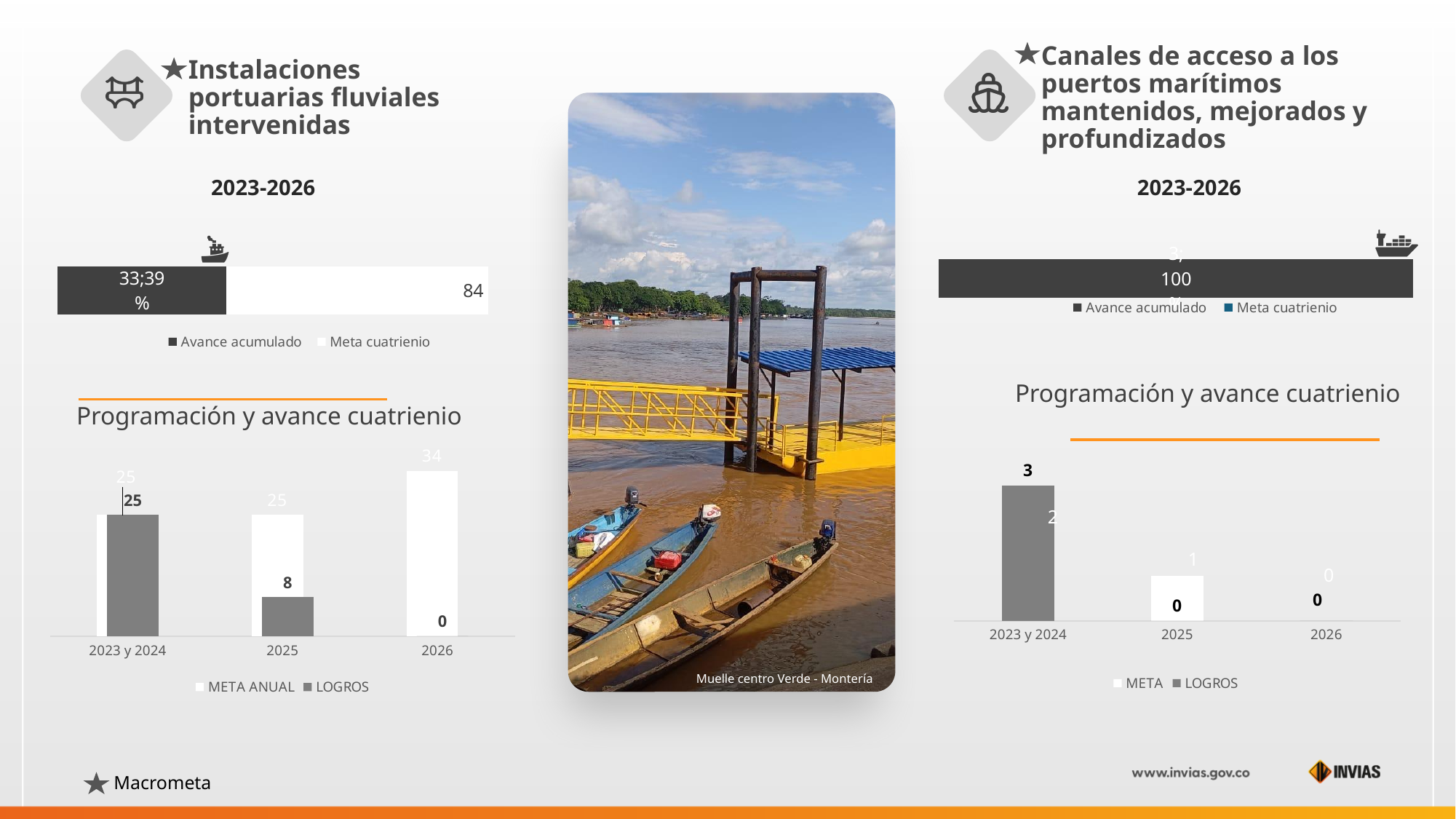
In the top-left 2023-2026 chart (Instalaciones portuarias fluviales), what is the Meta cuatrienio value? 84 In the right 'Programación y avance cuatrienio' chart (Canales de acceso a los puertos marítimos), what is the LOGROS value for 2023 y 2024? 3 In the right 'Programación y avance cuatrienio' chart (Canales de acceso a los puertos marítimos), which period has the highest LOGROS value? 2023 y 2024 In the left 'Programación y avance cuatrienio' chart (Instalaciones portuarias fluviales), do the LOGROS values rise or fall from 2023 y 2024 to 2026? fall In the left 'Programación y avance cuatrienio' chart (Instalaciones portuarias fluviales), which period has the highest META ANUAL value? 2026 What kind of chart is the left 'Programación y avance cuatrienio' chart (Instalaciones portuarias fluviales)? bar chart In the left 'Programación y avance cuatrienio' chart (Instalaciones portuarias fluviales), how many series does the legend list? 2 In the right 'Programación y avance cuatrienio' chart (Canales de acceso a los puertos marítimos), what is the META value for 2025? 1 In the left 'Programación y avance cuatrienio' chart (Instalaciones portuarias fluviales), what is the LOGROS value for 2025? 8 In the left 'Programación y avance cuatrienio' chart (Instalaciones portuarias fluviales), how many periods are shown on the x axis? 3 In the left 'Programación y avance cuatrienio' chart (Instalaciones portuarias fluviales), what is the META ANUAL value for 2026? 34 In the left 'Programación y avance cuatrienio' chart (Instalaciones portuarias fluviales), what is the difference between META ANUAL and LOGROS for 2025? 17